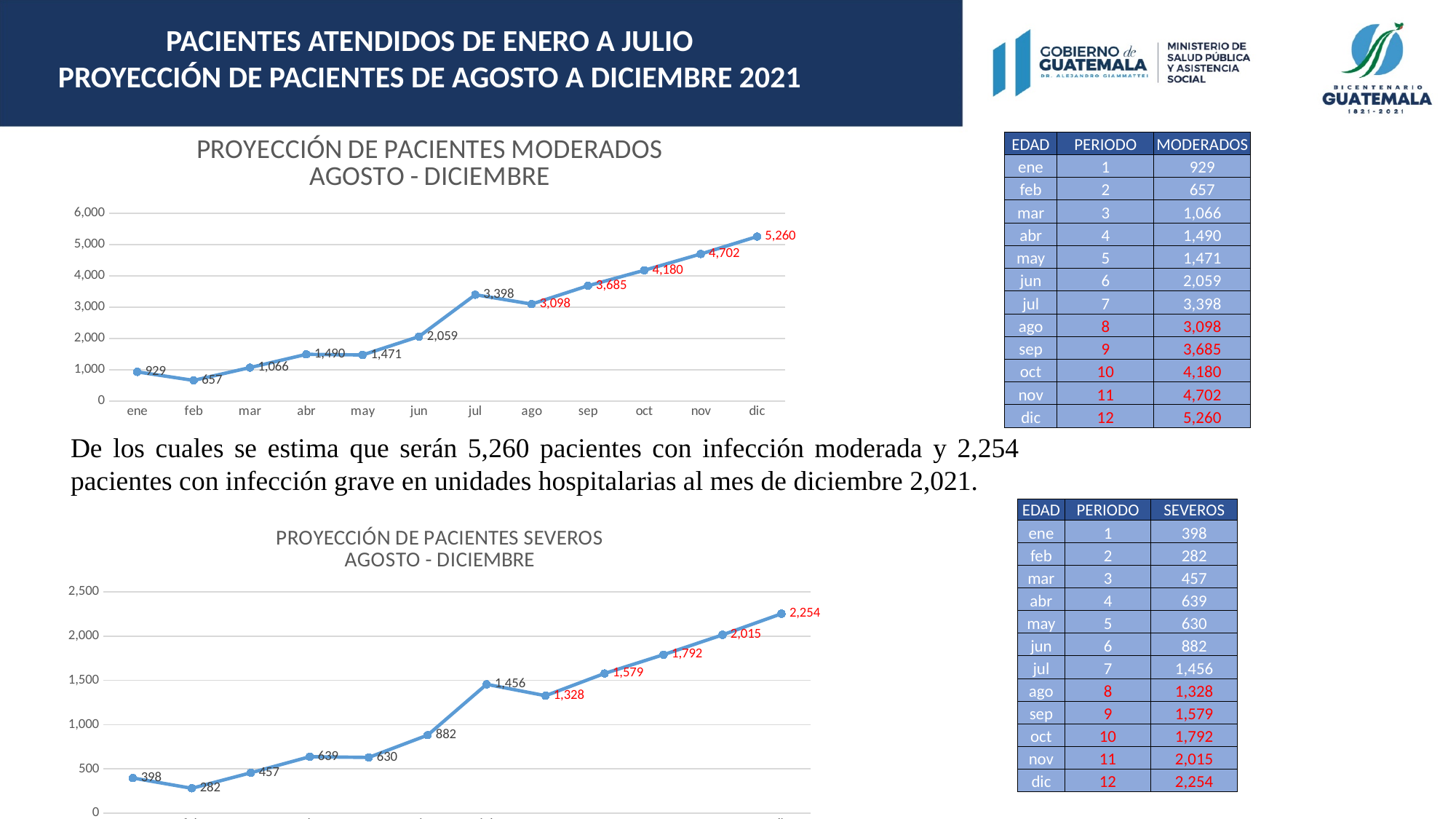
In the chart titled PROYECCIÓN DE PACIENTES MODERADOS AGOSTO - DICIEMBRE, what is the value for jul? 3,398 In the chart titled PROYECCIÓN DE PACIENTES SEVEROS AGOSTO - DICIEMBRE, what is the difference between the last data point (2,254) and the first data point (398)? 1,856 In the chart titled PROYECCIÓN DE PACIENTES MODERADOS AGOSTO - DICIEMBRE, how many months are plotted on the x axis? 12 In the chart titled PROYECCIÓN DE PACIENTES MODERADOS AGOSTO - DICIEMBRE, which is larger, the value for abr or the value for jun? jun In the chart titled PROYECCIÓN DE PACIENTES MODERADOS AGOSTO - DICIEMBRE, which month has the lowest value? feb In the chart titled PROYECCIÓN DE PACIENTES MODERADOS AGOSTO - DICIEMBRE, which month has the highest value? dic In the chart titled PROYECCIÓN DE PACIENTES MODERADOS AGOSTO - DICIEMBRE, what is the difference between the values for jul and ago? 300 In the chart titled PROYECCIÓN DE PACIENTES SEVEROS AGOSTO - DICIEMBRE, do the values generally rise or fall from left to right? rise What kind of chart is the chart titled PROYECCIÓN DE PACIENTES SEVEROS AGOSTO - DICIEMBRE? line chart In the chart titled PROYECCIÓN DE PACIENTES SEVEROS AGOSTO - DICIEMBRE, what is the highest value shown? 2,254 In the chart titled PROYECCIÓN DE PACIENTES MODERADOS AGOSTO - DICIEMBRE, what is the value for dic? 5,260 In the chart titled PROYECCIÓN DE PACIENTES SEVEROS AGOSTO - DICIEMBRE, what is the lowest value shown? 282